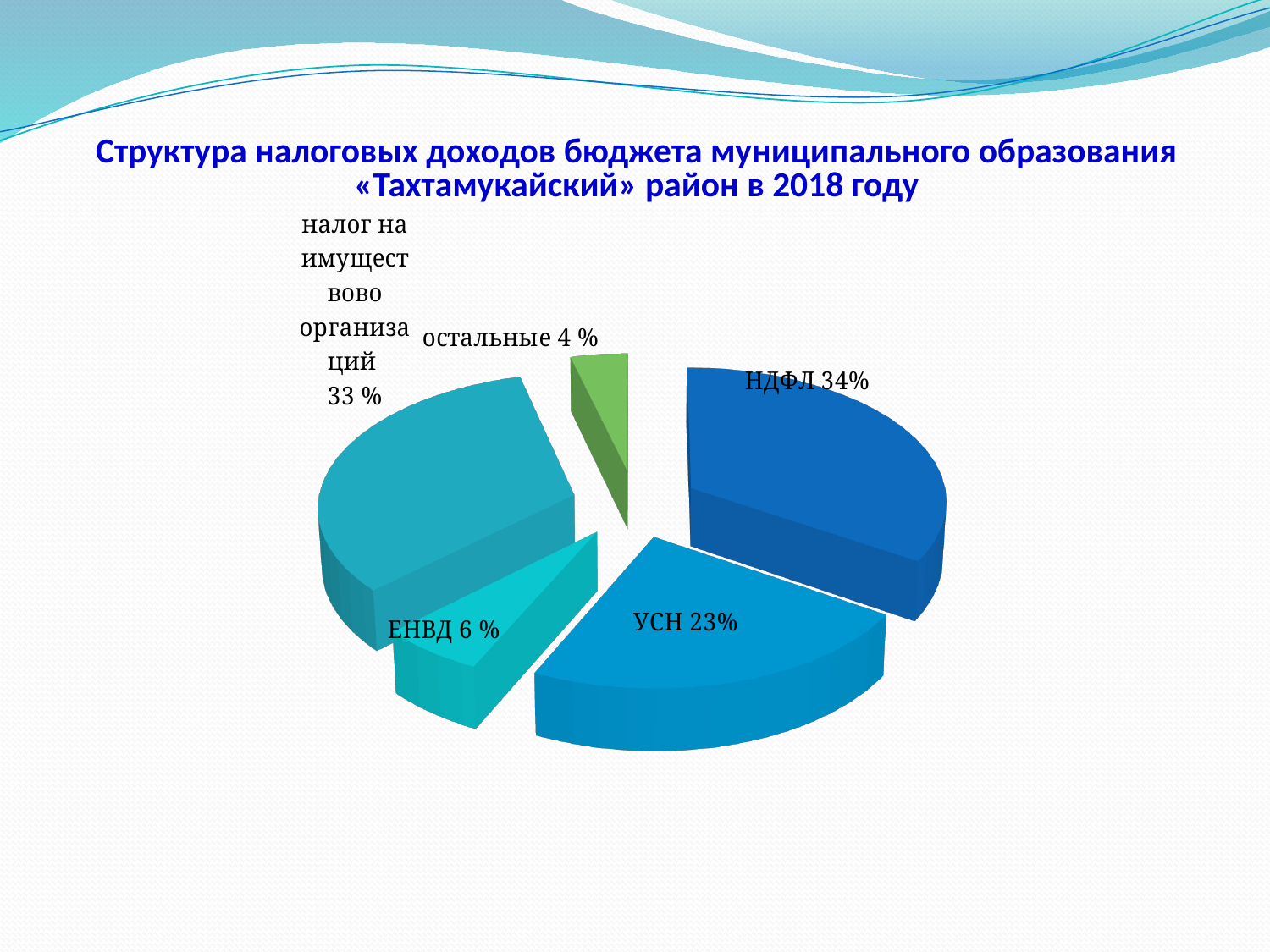
What share of the pie does остальные have? 4 % What year does the chart title say the data refers to? 2018 Which slice of the pie is the largest? НДФЛ What share of the pie does НДФЛ have? 34% What share of the pie does налог на имущество организаций have? 33 % What kind of chart is shown on the slide? pie chart What is the difference in percentage points between the НДФЛ share and the УСН share? 11 How many slices does the pie chart have? 5 Which is larger, the share for УСН or the share for ЕНВД? УСН Which slice of the pie is the smallest? остальные What share of the pie does ЕНВД have? 6 % What share of the pie does УСН have? 23%